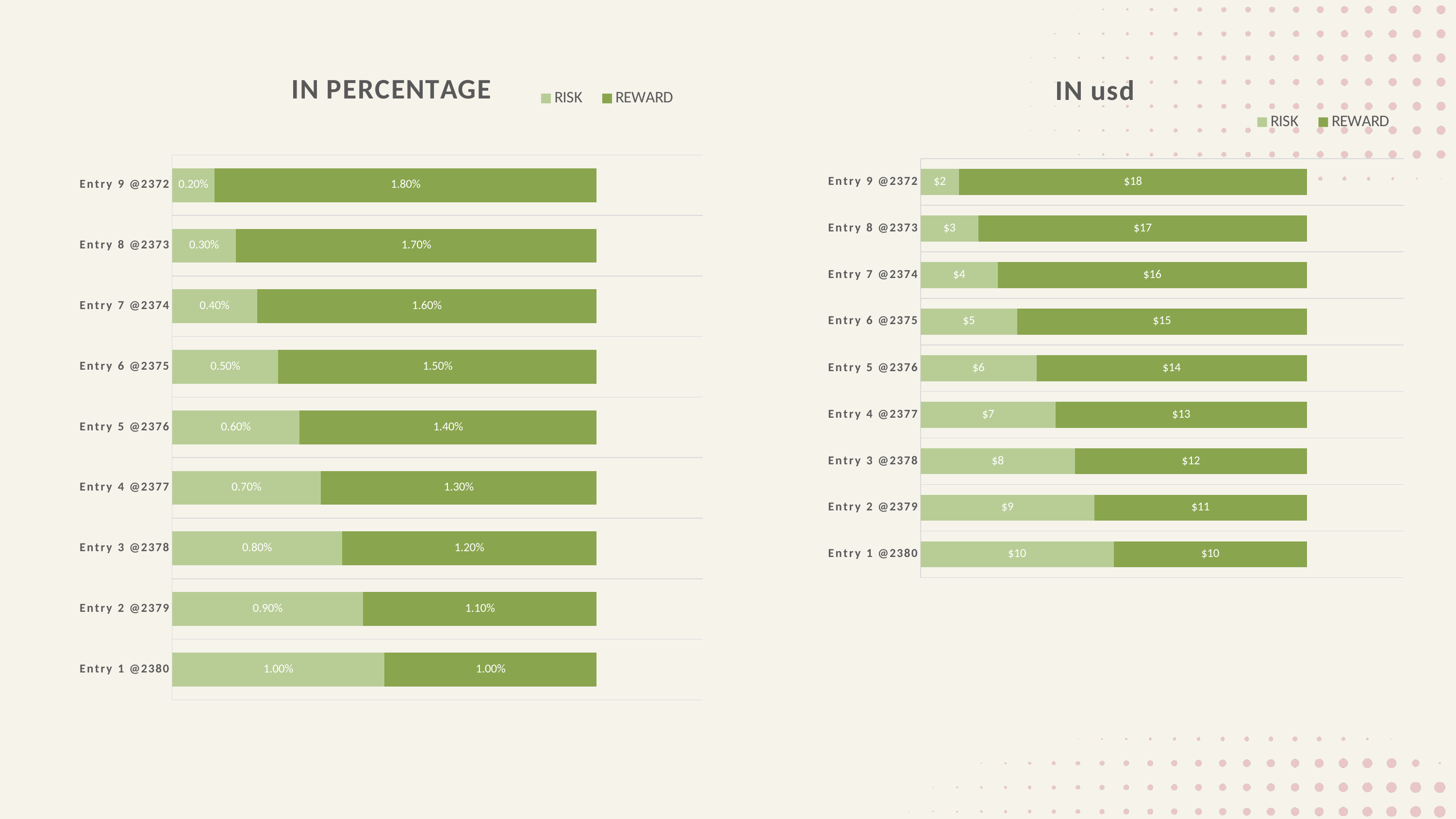
In the 'IN PERCENTAGE' chart, what is the REWARD value for Entry 3 @2378? 1.20% In the 'IN PERCENTAGE' chart, which entry has the highest REWARD value? Entry 9 @2372 In the 'IN PERCENTAGE' chart, which is larger for Entry 4 @2377: RISK or REWARD? REWARD In the 'IN usd' chart, which entry has the lowest RISK value? Entry 9 @2372 In the 'IN usd' chart, what is the difference between the REWARD and RISK values for Entry 7 @2374? $12 How many entries are shown in the 'IN usd' chart? 9 In the 'IN usd' chart, what is the REWARD value for Entry 6 @2375? $15 In the 'IN PERCENTAGE' chart, what is the RISK value for Entry 7 @2374? 0.40% In the 'IN usd' chart, what is the RISK value for Entry 2 @2379? $9 How many series does the legend of the 'IN PERCENTAGE' chart list? 2 In the 'IN usd' chart, what is the total of the stacked bar for Entry 5 @2376? $20 What kind of chart is the 'IN usd' chart? Stacked bar chart